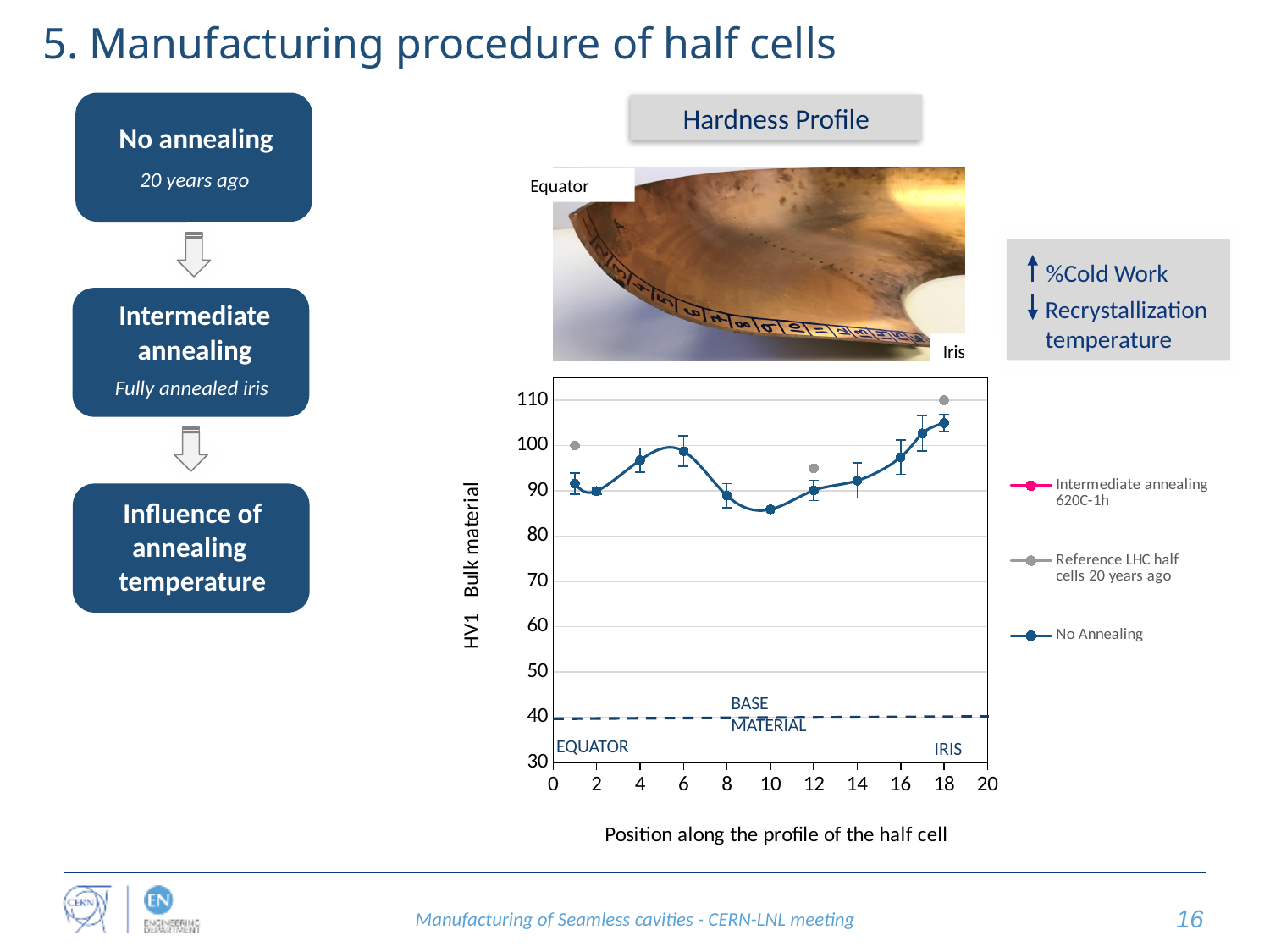
In the Hardness Profile chart, at which position does the No Annealing series reach its highest value? 18 In the Hardness Profile chart, is the Reference LHC half cells 20 years ago value at position 12 greater or less than 100? less What is the x-axis label of the Hardness Profile chart? Position along the profile of the half cell What is the y-axis label of the Hardness Profile chart? HV1 Bulk material In the Hardness Profile chart, which is larger for the No Annealing series: the value at position 6 or the value at position 8? position 6 In the Hardness Profile chart, at which position does the No Annealing series reach its lowest value? 10 In the Hardness Profile chart, does the No Annealing series rise or fall between position 10 and position 18? rise How many series does the legend of the Hardness Profile chart list? 3 In the Hardness Profile chart, is the No Annealing value at position 10 greater or less than 90? less What kind of chart is the Hardness Profile chart? line chart In the Hardness Profile chart, is the No Annealing value at position 18 greater or less than 100? greater How many points are plotted for the Reference LHC half cells 20 years ago series in the Hardness Profile chart? 3